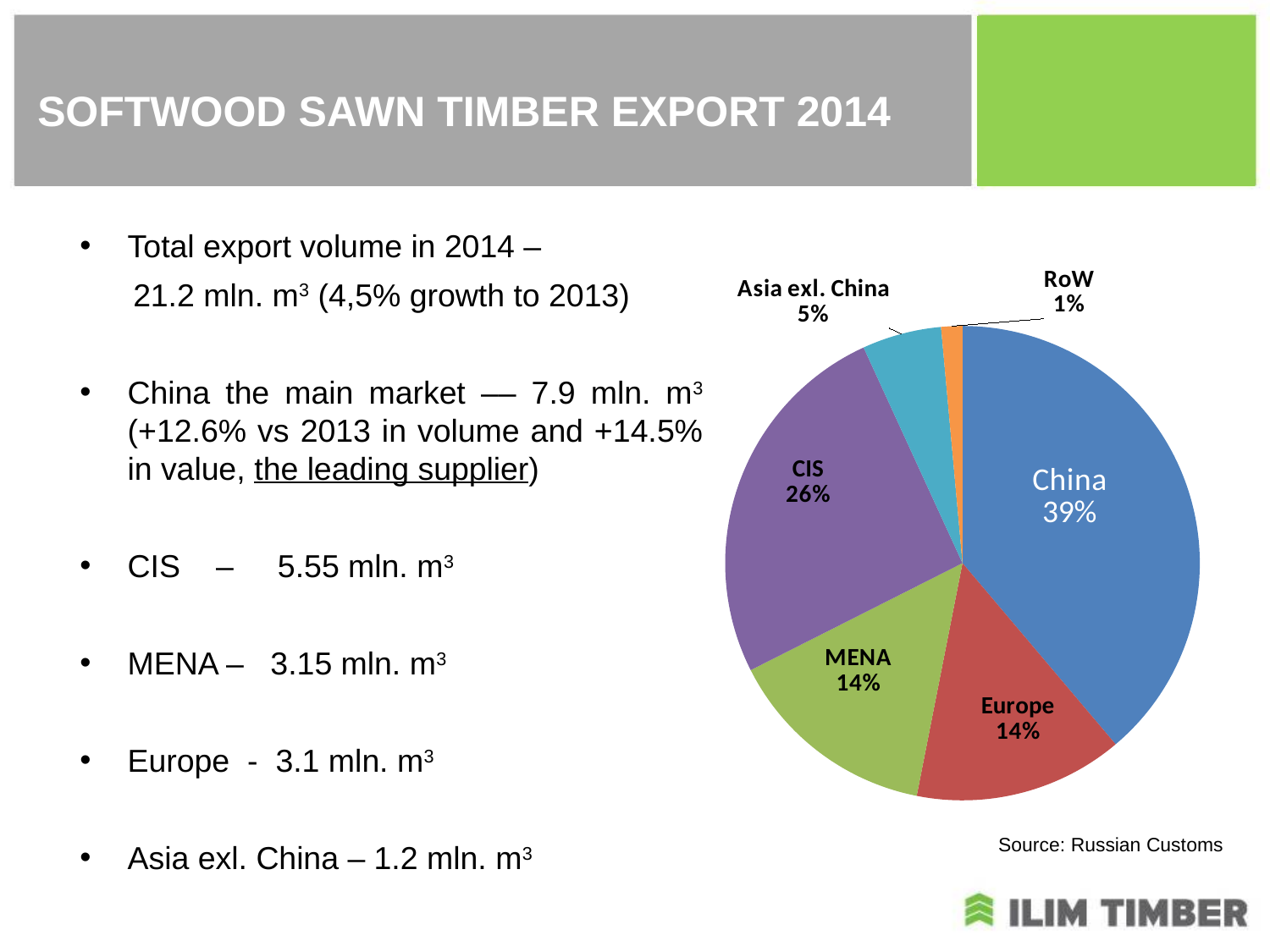
What colour is the China slice of the pie? blue What share of the pie does RoW have? 1% Which category has the smallest slice of the pie? RoW What share of the pie does CIS have? 26% What is the difference in percentage points between the CIS slice and the Asia exl. China slice? 21 What share of the pie does Asia exl. China have? 5% Which slice is larger, CIS or MENA? CIS How many slices does the pie chart have? 6 Which category has the largest slice of the pie? China What kind of chart is shown on the slide? pie chart What is the difference in percentage points between the China slice and the CIS slice? 13